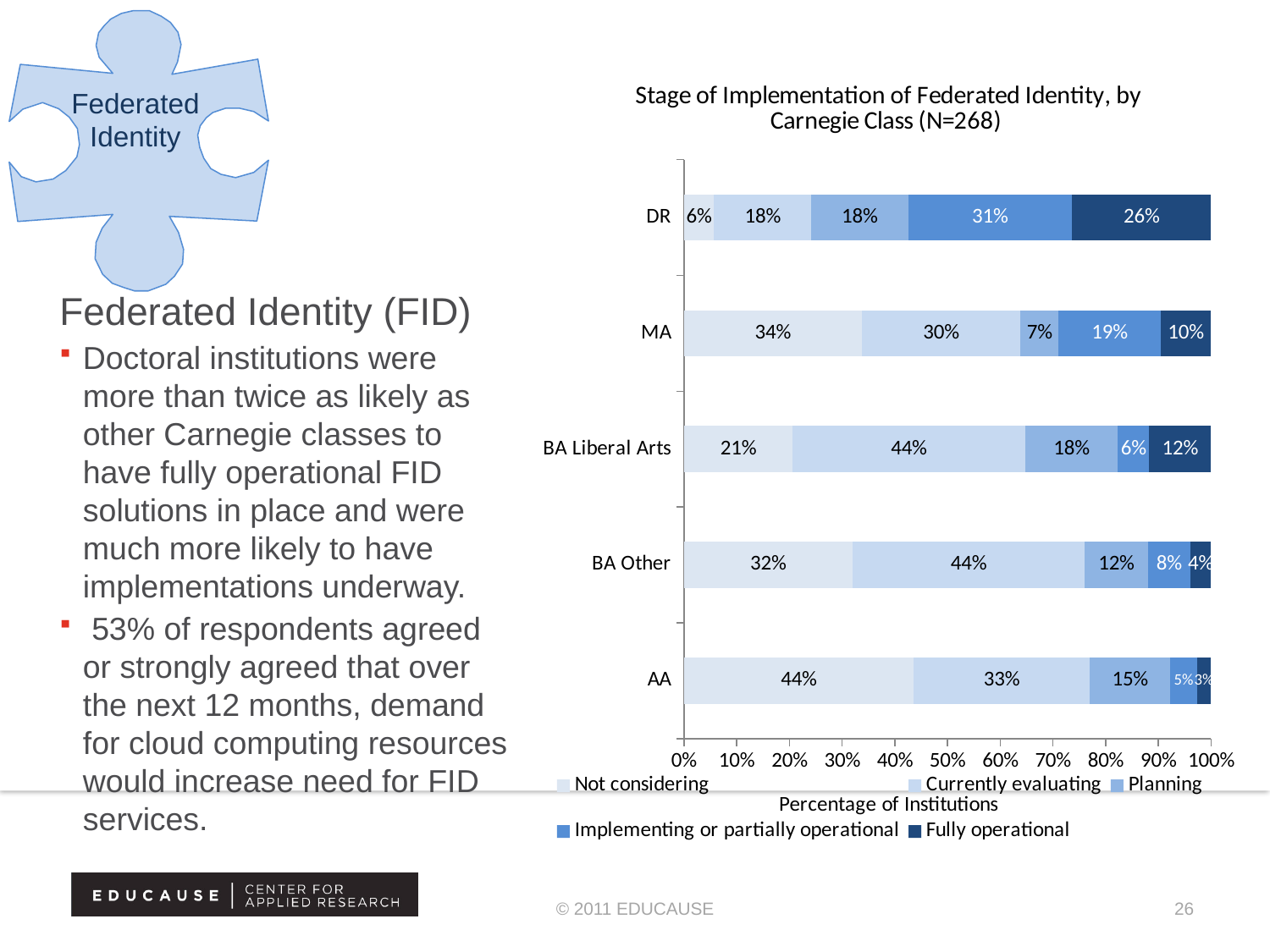
Which Carnegie class has the highest percentage of fully operational institutions? DR What type of chart is shown on the slide? Stacked bar chart How many Carnegie classes are shown on the chart? 5 Which Carnegie class has the lowest percentage of institutions not considering federated identity? DR What is the difference between the fully operational percentage for DR and for MA? 16% What percentage of BA Liberal Arts institutions are currently evaluating? 44% What percentage of MA institutions are not considering federated identity? 34% What is the title of the chart? Stage of Implementation of Federated Identity, by Carnegie Class (N=268) How many series does the legend list? 5 Which is larger: the implementing or partially operational percentage for DR or for BA Other? DR What percentage of AA institutions are planning? 15% What percentage of DR institutions are fully operational? 26%